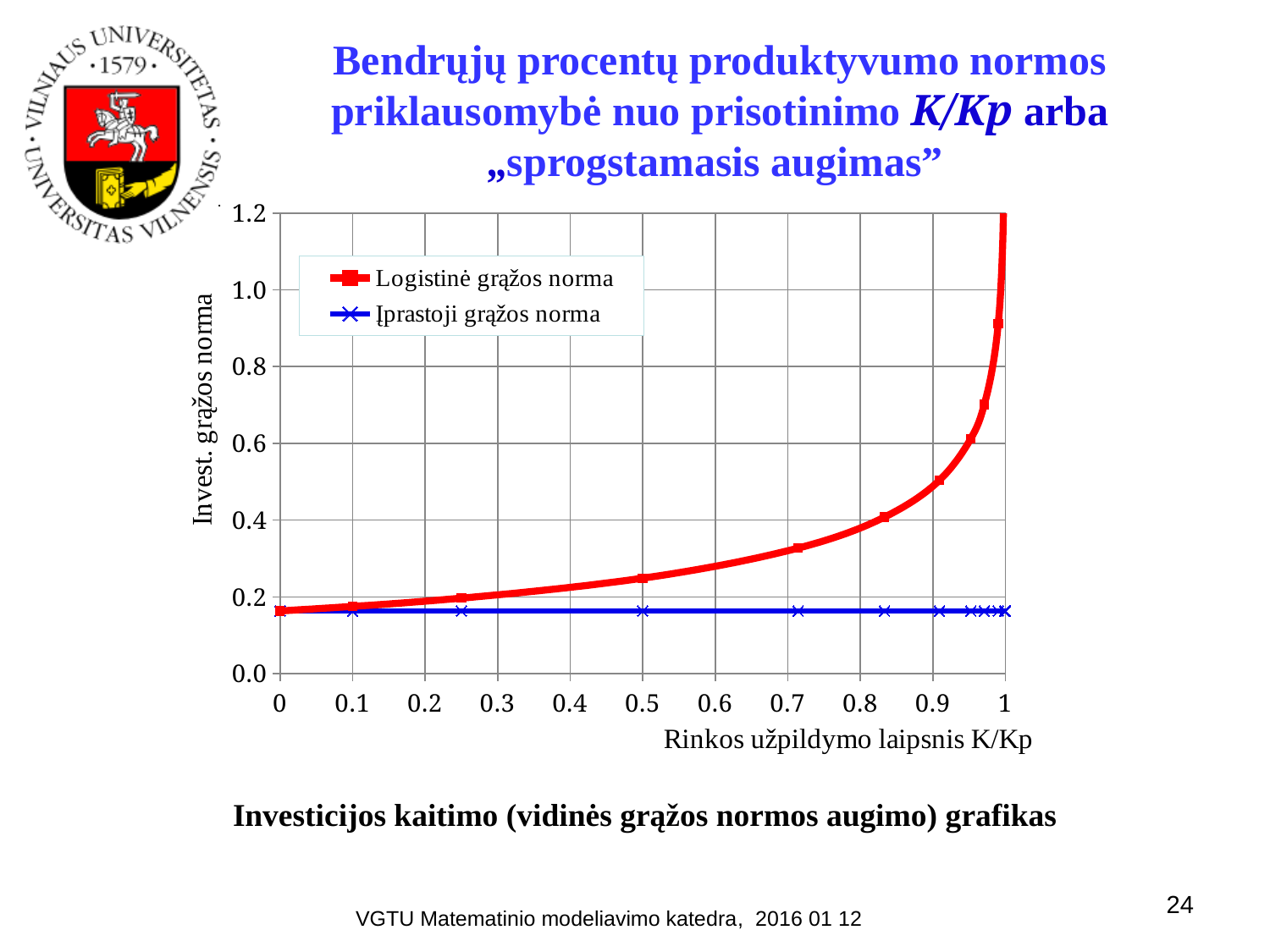
Which series is drawn in red with square markers? Logistinė grąžos norma Is the value of Logistinė grąžos norma at K/Kp = 0.9 greater or less than 0.6? less Does the Logistinė grąžos norma series rise or fall as K/Kp increases from 0 to 1? rise Is the value of Logistinė grąžos norma at K/Kp = 0.9 greater or less than 0.4? greater Is the value of Logistinė grąžos norma at K/Kp = 0.5 greater or less than 0.2? greater What is the label of the x axis? Rinkos užpildymo laipsnis K/Kp Which series reaches the highest value on the chart? Logistinė grąžos norma Does the Įprastoji grąžos norma series rise, fall or stay flat as K/Kp increases? stay flat At K/Kp = 0.8, which series has the larger value, Logistinė grąžos norma or Įprastoji grąžos norma? Logistinė grąžos norma What kind of chart is shown on the slide? line chart How many series does the legend list? 2